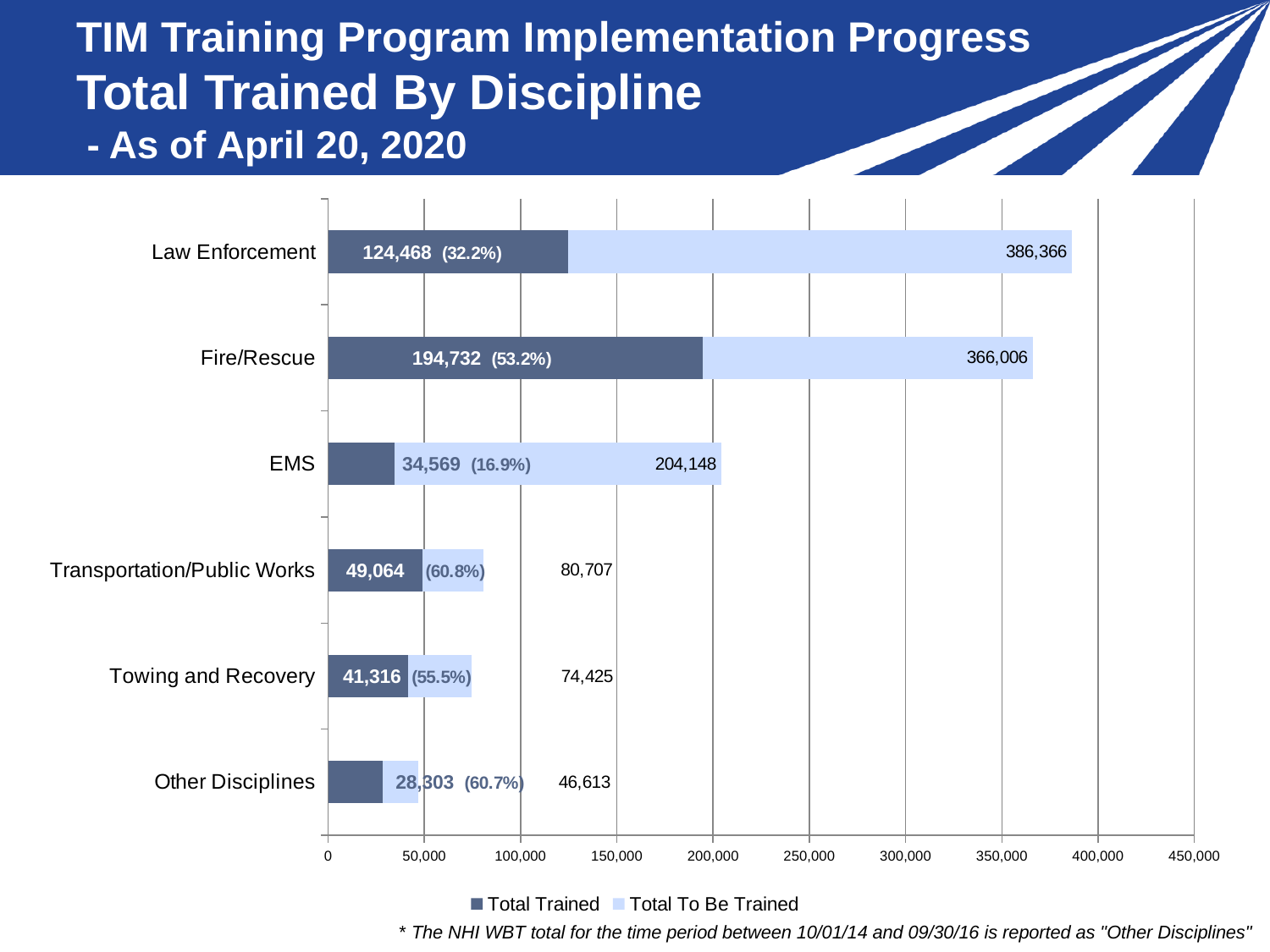
Which discipline has the highest Total Trained value? Fire/Rescue What is the value printed at the end of the Law Enforcement bar? 386,366 What are the two legend entries on the chart? Total Trained, Total To Be Trained Which discipline has the lowest Total Trained value? Other Disciplines What is the Total Trained value for Fire/Rescue? 194,732 What percentage is shown for Towing and Recovery? 55.5% What is the difference between the Law Enforcement bar total (386,366) and the Fire/Rescue bar total (366,006)? 20,360 What percentage is shown for EMS? 16.9% How many series does the legend list? 2 What kind of chart is shown on the slide? bar chart Which has the larger Total Trained value, Transportation/Public Works or Towing and Recovery? Transportation/Public Works How many disciplines are shown on the chart? 6